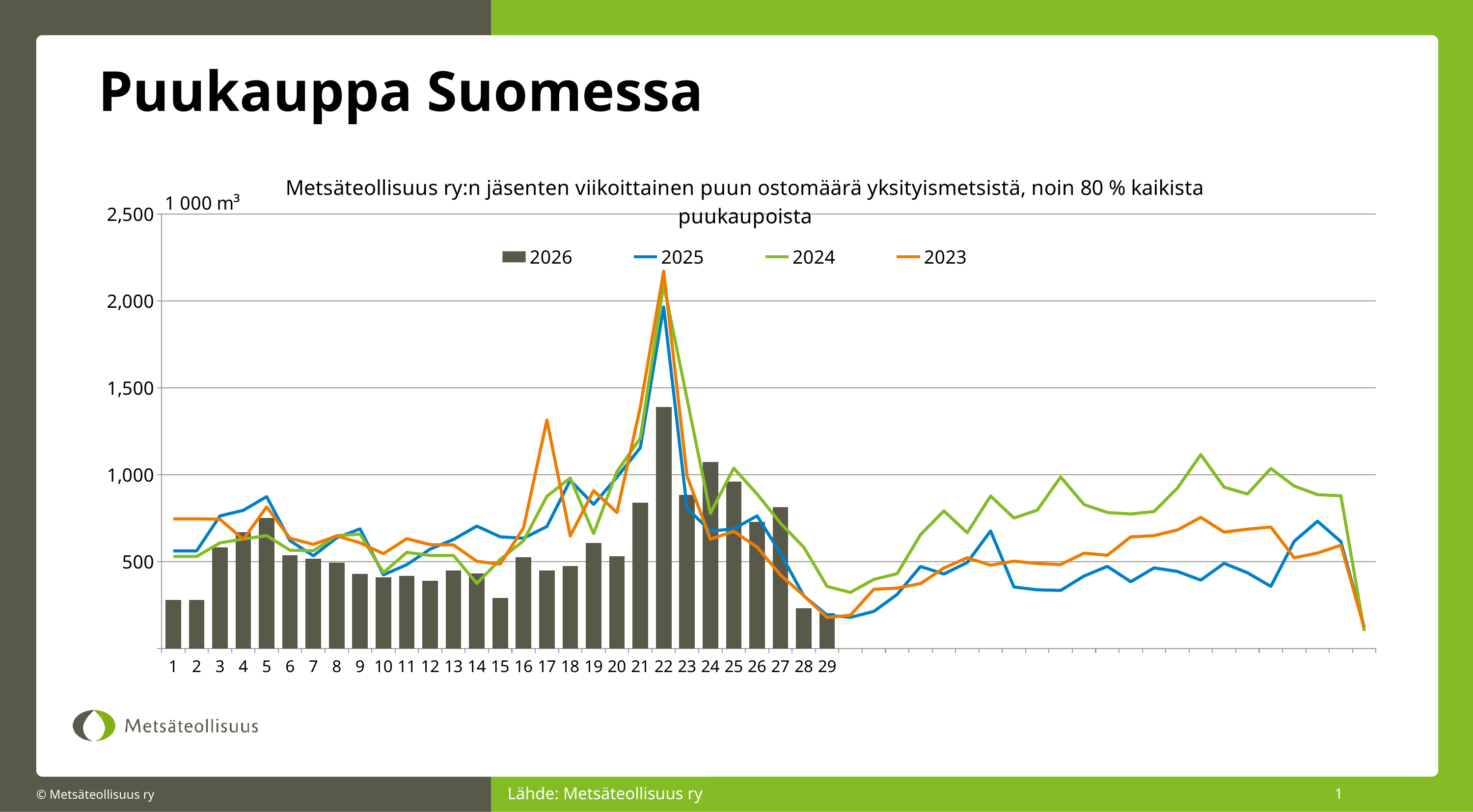
How many weeks have a 2026 bar plotted? 29 How many series does the legend list? 4 In which week is the 2026 bar lowest? 29 Do the 2026 bars rise or fall from week 22 to week 29? fall What unit label is shown above the vertical axis? 1 000 m³ Which series is drawn as bars? 2026 Is the 2026 value for week 22 greater or less than 1,000? greater Which series reaches the highest peak at week 22? 2023 Which is larger, the 2026 value for week 22 or for week 23? Week 22 In which week is the 2026 bar highest? 22 What kind of chart is shown on the slide? A combined bar and line chart Is the 2026 value for week 1 greater or less than 500? less